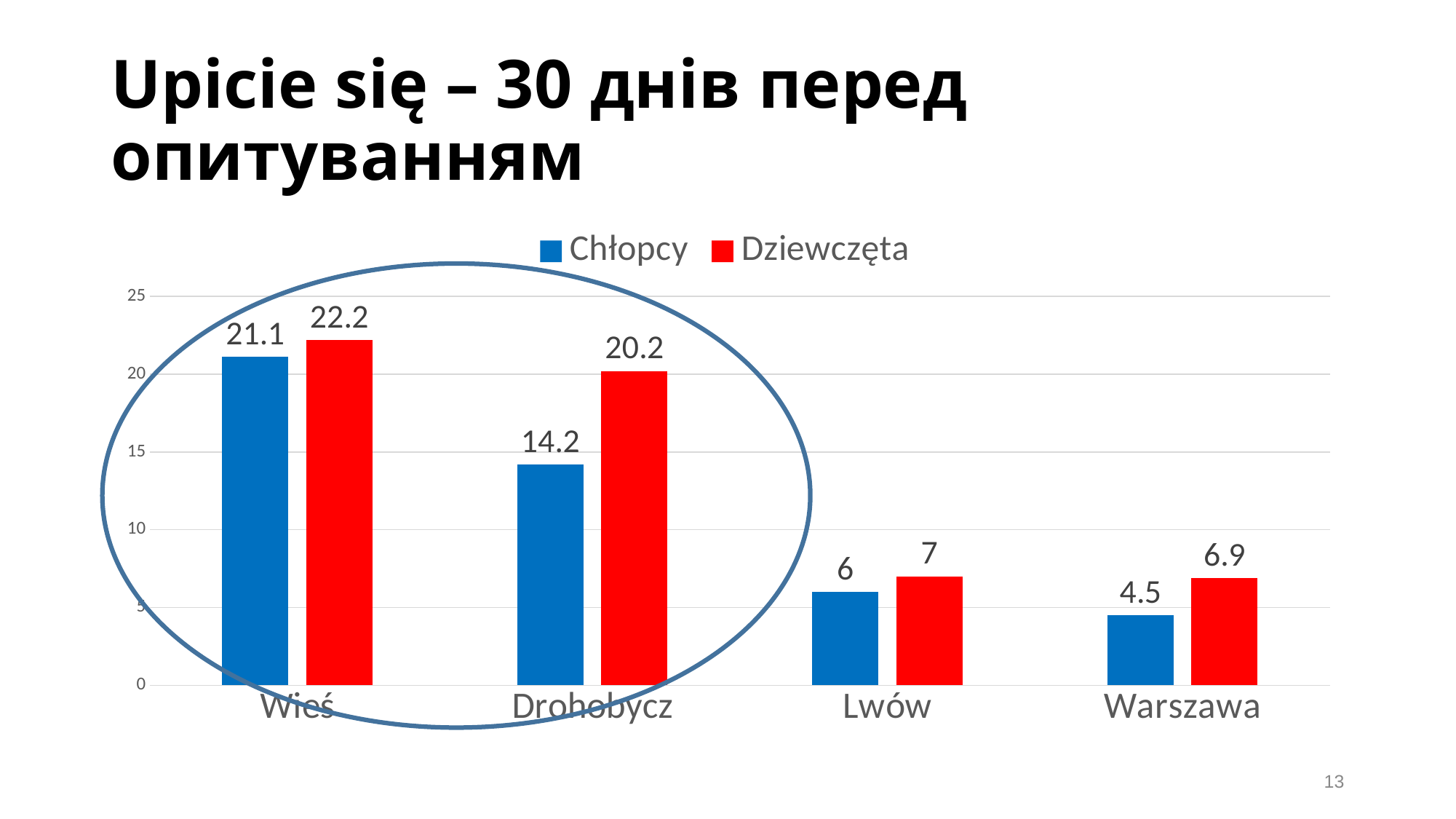
Which is larger in Wieś, the value for Chłopcy or for Dziewczęta? Dziewczęta What is the difference between Dziewczęta and Chłopcy in Drohobycz? 6 What is the value for Chłopcy in Wieś? 21.1 What is the value for Dziewczęta in Lwów? 7 What colour are the bars for the Dziewczęta series? Red What is the value for Dziewczęta in Drohobycz? 20.2 Which category has the lowest value for Chłopcy? Warszawa What is the value for Chłopcy in Warszawa? 4.5 What kind of chart is shown on the slide? Bar chart How many categories are shown on the x axis? 4 Which category has the highest value for Dziewczęta? Wieś How many series does the legend list? 2